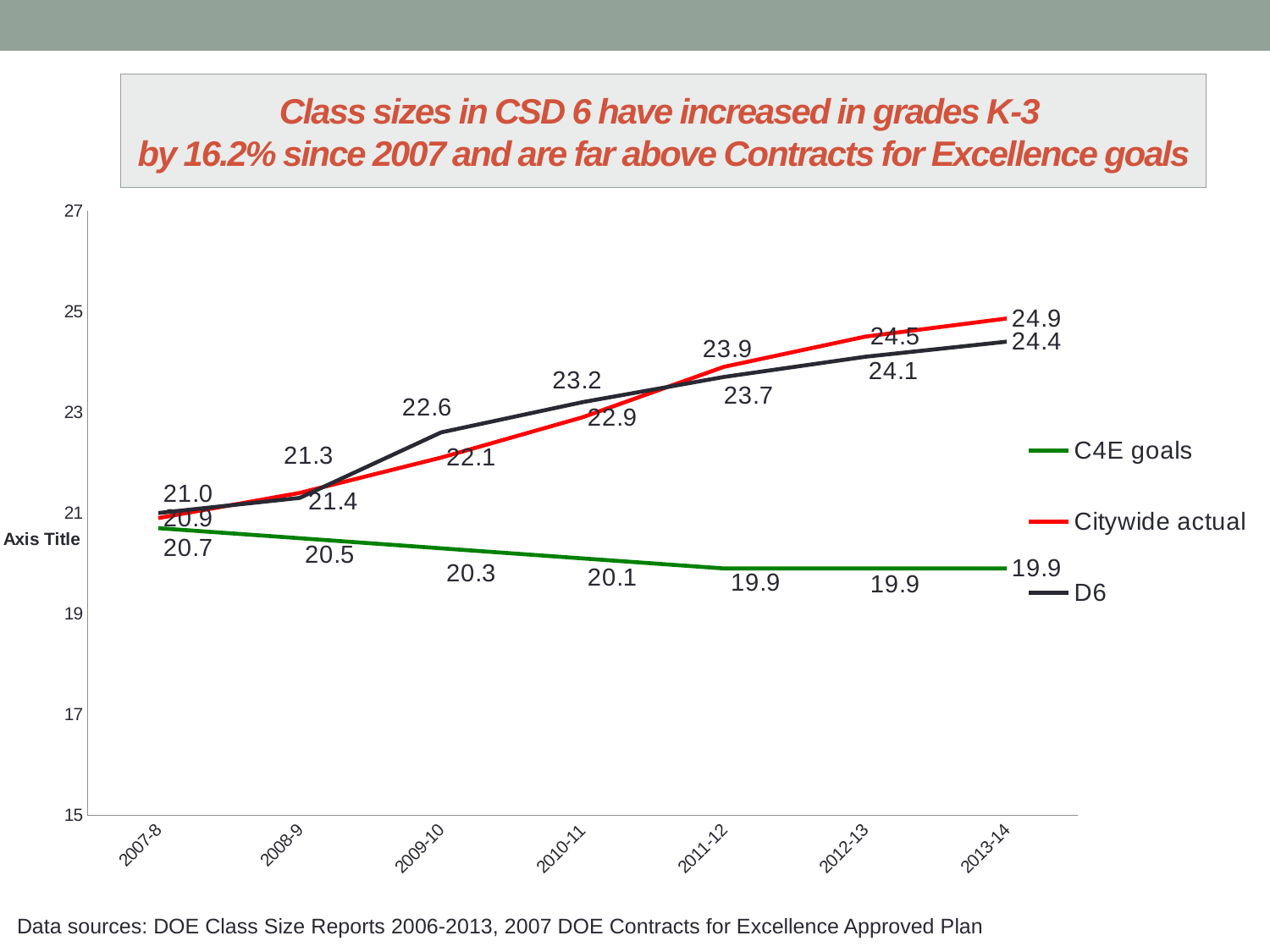
In 2009-10, which is larger: the D6 value or the Citywide actual value? D6 What is the C4E goals value for 2013-14? 19.9 What is the C4E goals value for 2007-8? 20.7 What colour is the Citywide actual line in the legend? red What is the difference between the Citywide actual and D6 values in 2013-14? 0.5 In which school year is the Citywide actual value highest? 2013-14 What is the D6 value for 2013-14? 24.4 What kind of chart is shown on the slide? line chart What is the Citywide actual value for 2013-14? 24.9 How many series does the legend list? 3 Do the C4E goals values rise or fall from 2007-8 to 2013-14? fall How many school years are plotted along the x axis? 7